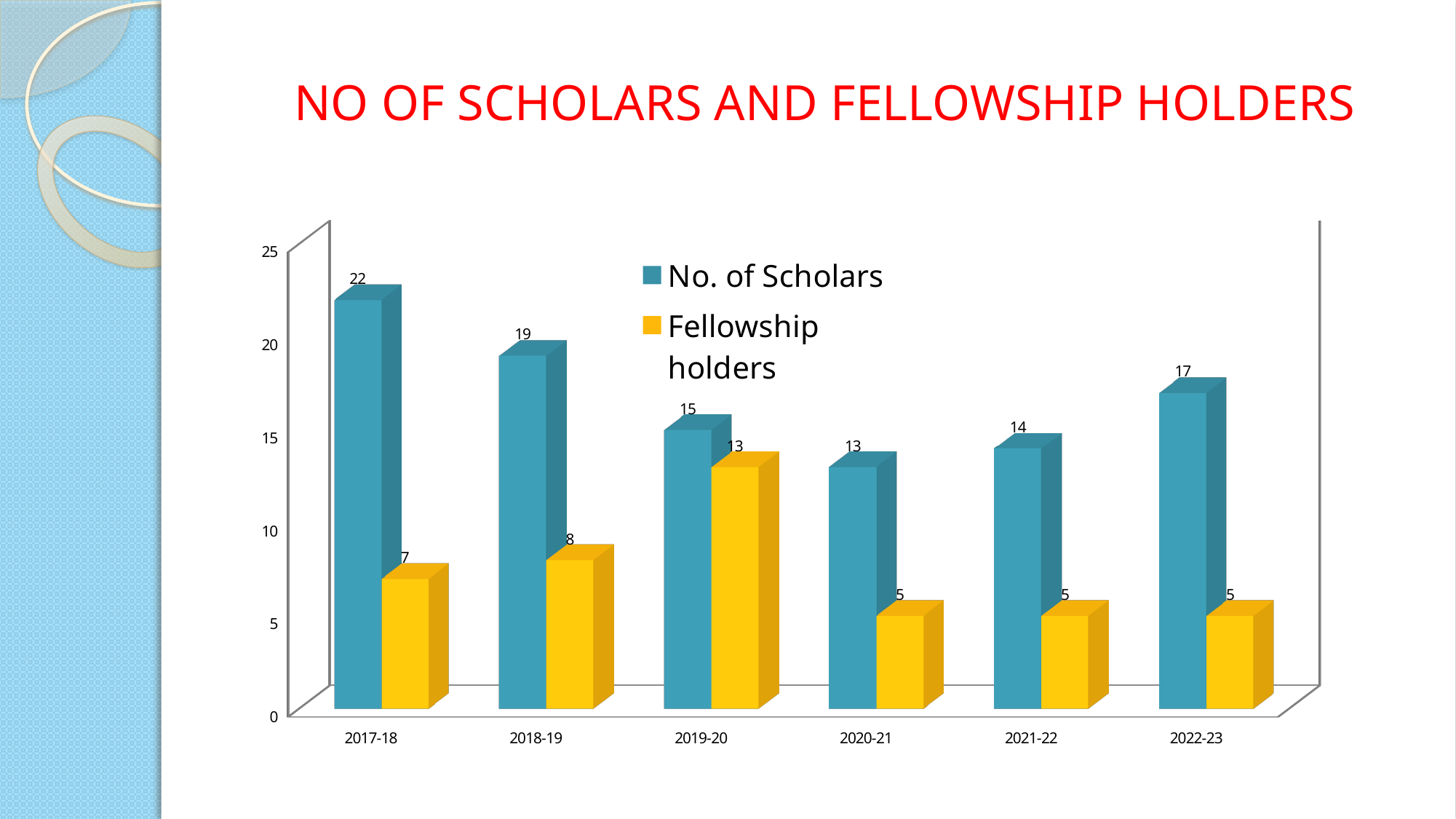
What is the number of scholars in 2017-18? 22 Which year has the lowest number of scholars? 2020-21 How many years are shown on the x axis? 6 Which year has the highest number of scholars? 2017-18 What is the title of the chart? NO OF SCHOLARS AND FELLOWSHIP HOLDERS What is the difference between the number of scholars and fellowship holders in 2018-19? 11 Which is larger: the number of scholars in 2021-22 or in 2022-23? 2022-23 Which year has the highest number of fellowship holders? 2019-20 What kind of chart is shown on the slide? Bar chart What is the number of scholars in 2022-23? 17 How many fellowship holders were there in 2019-20? 13 How many series does the legend list? 2